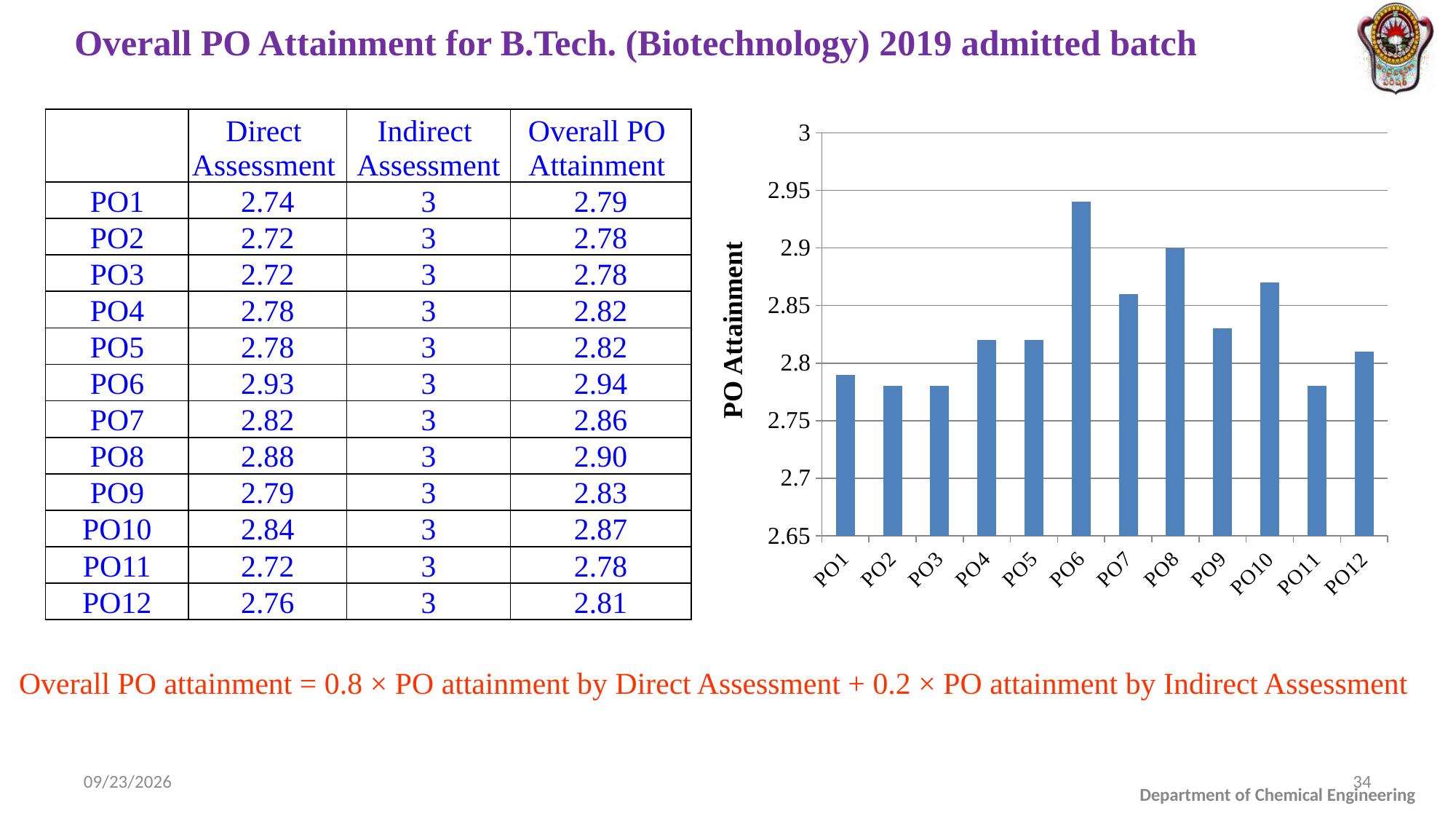
How many PO categories are plotted on the x axis of the chart? 12 Is the value for PO11 greater or less than 2.8? less What is the overall PO attainment value for PO6? 2.94 What is the overall PO attainment value for PO10? 2.87 Which has a higher overall PO attainment, PO6 or PO8? PO6 Which PO has the highest overall PO attainment in the chart? PO6 What is the overall PO attainment value for PO8? 2.90 What kind of chart is shown on the slide? bar chart What is the title of the vertical axis of the chart? PO Attainment Is the value for PO9 greater or less than 2.85? less Is the value for PO6 greater or less than 2.9? greater What is the difference between the overall PO attainment of PO6 and PO8? 0.04